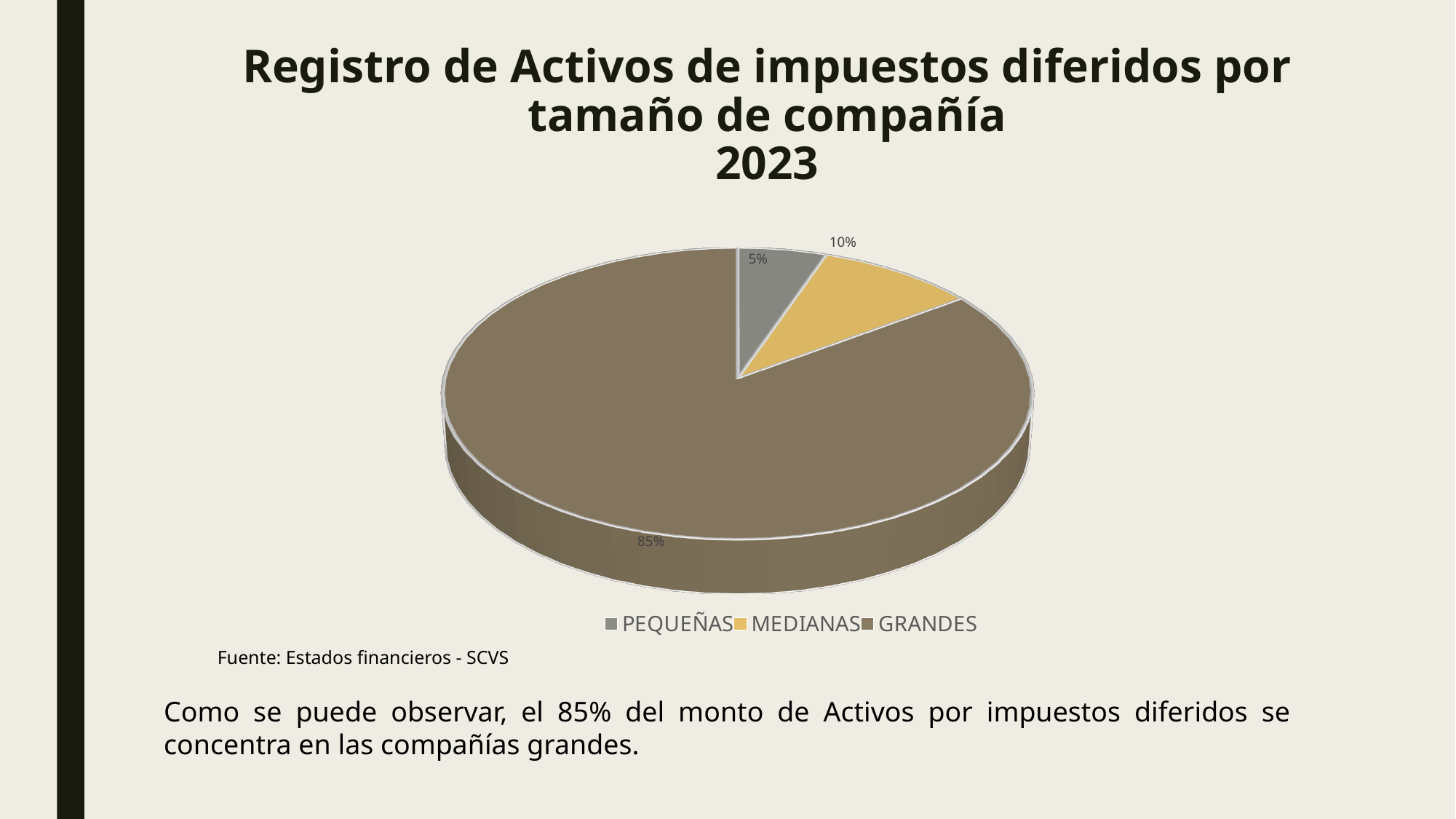
What kind of chart is shown on the slide? Pie chart What share of the pie does PEQUEÑAS represent? 5% Which category has the largest slice of the pie? GRANDES Which category has the smallest slice of the pie? PEQUEÑAS What is the difference in percentage points between the MEDIANAS and PEQUEÑAS slices? 5 How many categories does the pie chart show? 3 What share of the pie does GRANDES represent? 85% What share of the pie does MEDIANAS represent? 10% Which slice is larger, MEDIANAS or PEQUEÑAS? MEDIANAS What year is given in the chart title? 2023 Which category is shown in yellow in the legend? MEDIANAS What is the difference in percentage points between the GRANDES and MEDIANAS slices? 75